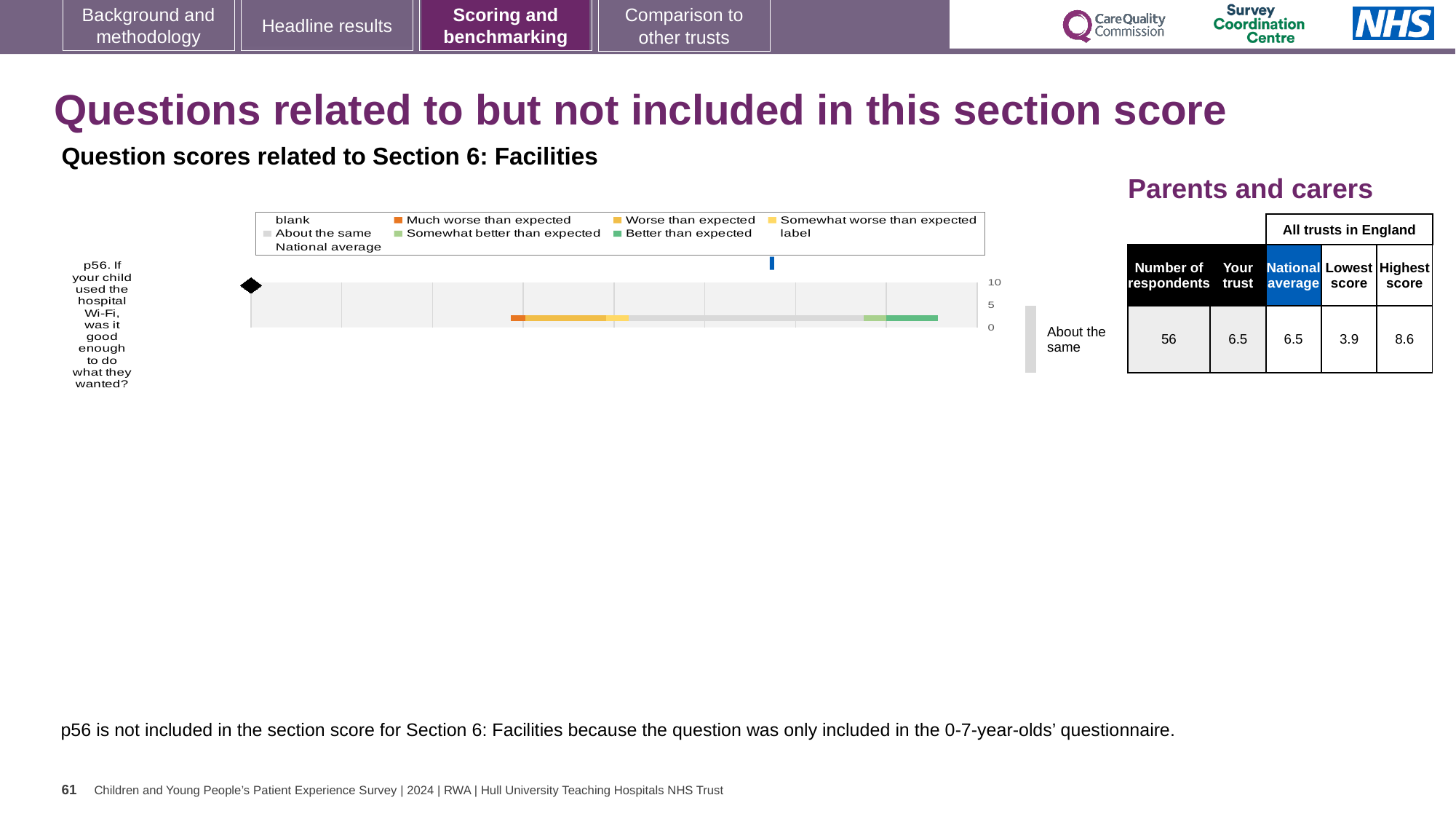
According to the table next to the chart, how many respondents answered p56? 56 What kind of chart is used to show the p56 question score? bar chart What is the national average score for p56? 6.5 Is the trust's score for p56 higher than, lower than, or the same as the national average? the same What is the lowest score among all trusts in England for p56? 3.9 Which benchmark category does the trust's p56 score fall into? About the same How many questions (categories) are plotted in the chart? 1 What is the 'Your trust' score for p56? 6.5 What is the highest score among all trusts in England for p56? 8.6 What is the difference between the highest and lowest scores for p56 across all trusts in England? 4.7 Which legend colour represents 'Much worse than expected'? orange What is the highest value shown on the chart's numeric axis? 10